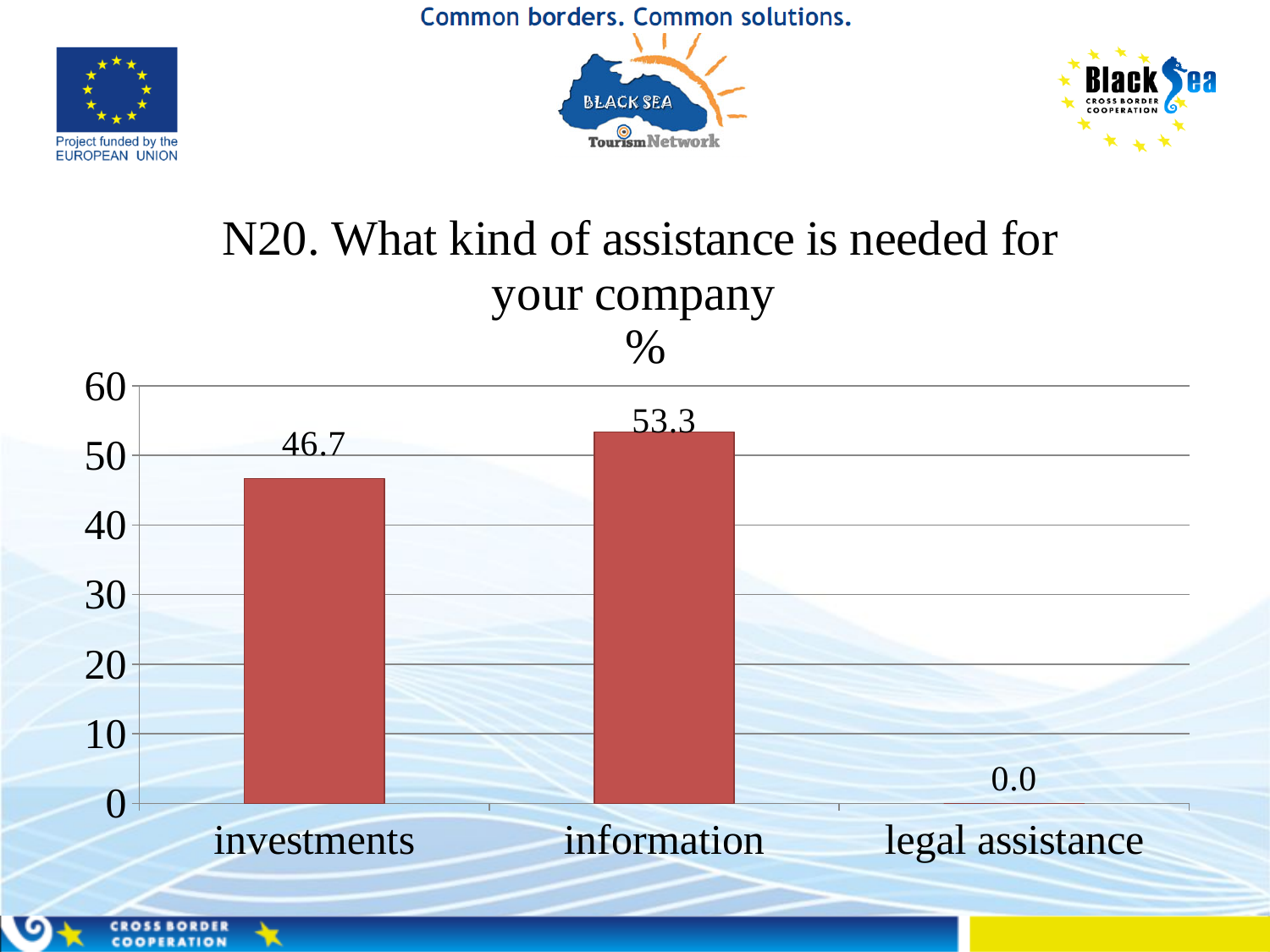
Which category has the highest value? information Which is larger, the value for investments or the value for information? information What kind of chart is shown on the slide? bar chart What is the value for legal assistance? 0.0 Is the value for information greater or less than 50? greater What is the value for information? 53.3 What is the value for investments? 46.7 Is the value for investments greater or less than 50? less What is the title of the chart? N20. What kind of assistance is needed for your company % Which category has the lowest value? legal assistance How many categories are shown on the x axis? 3 What is the difference between the values for information and investments? 6.6